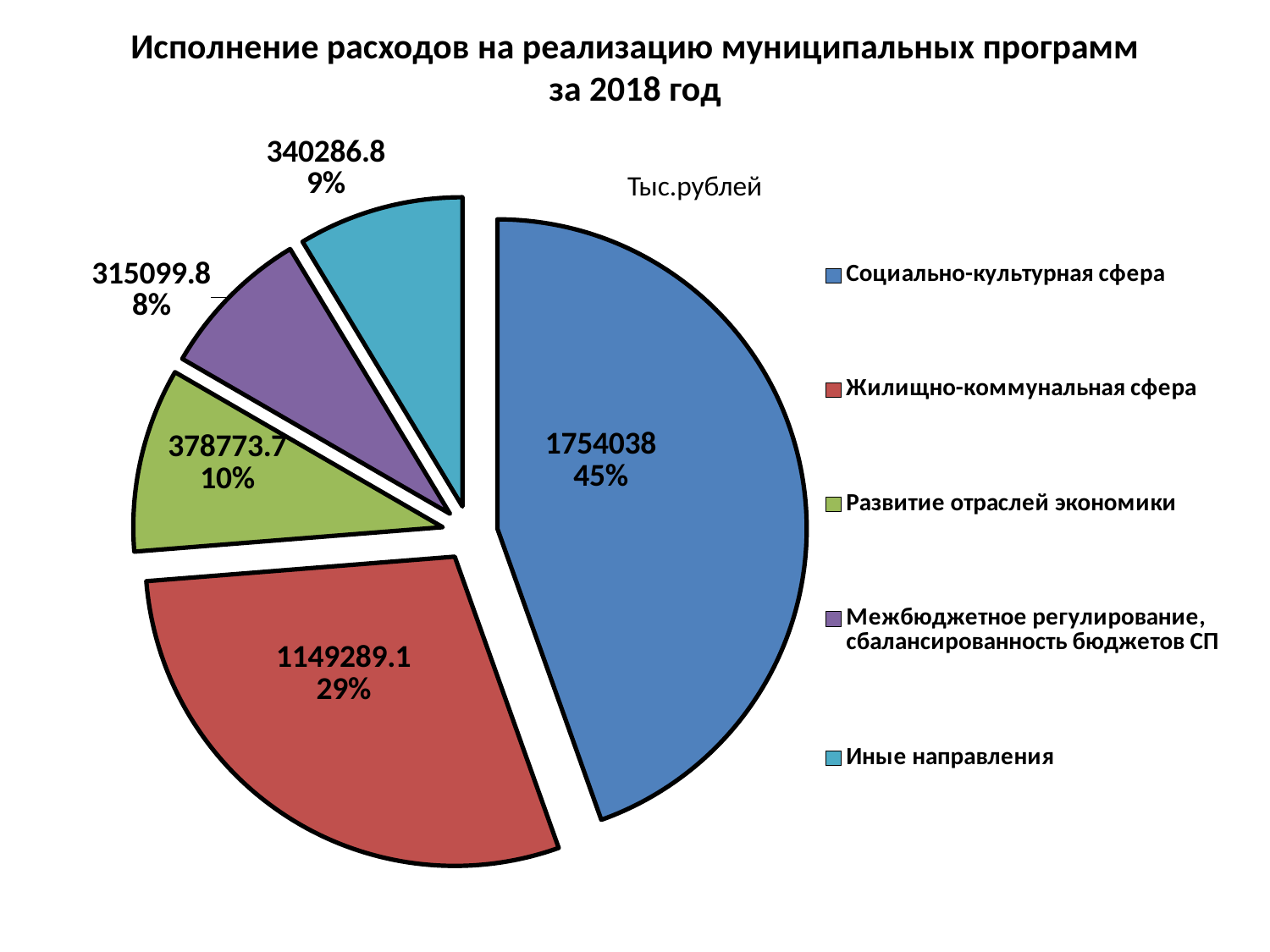
Which is larger, the value for Иные направления or the value for Межбюджетное регулирование, сбалансированность бюджетов СП? Иные направления What is the value for Развитие отраслей экономики? 378773.7 What is the value for Жилищно-коммунальная сфера? 1149289.1 What share of the pie does Социально-культурная сфера represent? 45% Which category has the smallest slice? Межбюджетное регулирование, сбалансированность бюджетов СП What is the value for Иные направления? 340286.8 Which category has the largest slice? Социально-культурная сфера What share of the pie does Межбюджетное регулирование, сбалансированность бюджетов СП represent? 8% What type of chart is shown on the slide? pie chart How many categories does the pie chart have? 5 What is the value for Социально-культурная сфера? 1754038 What is the difference between the values for Социально-культурная сфера and Жилищно-коммунальная сфера? 604748.9